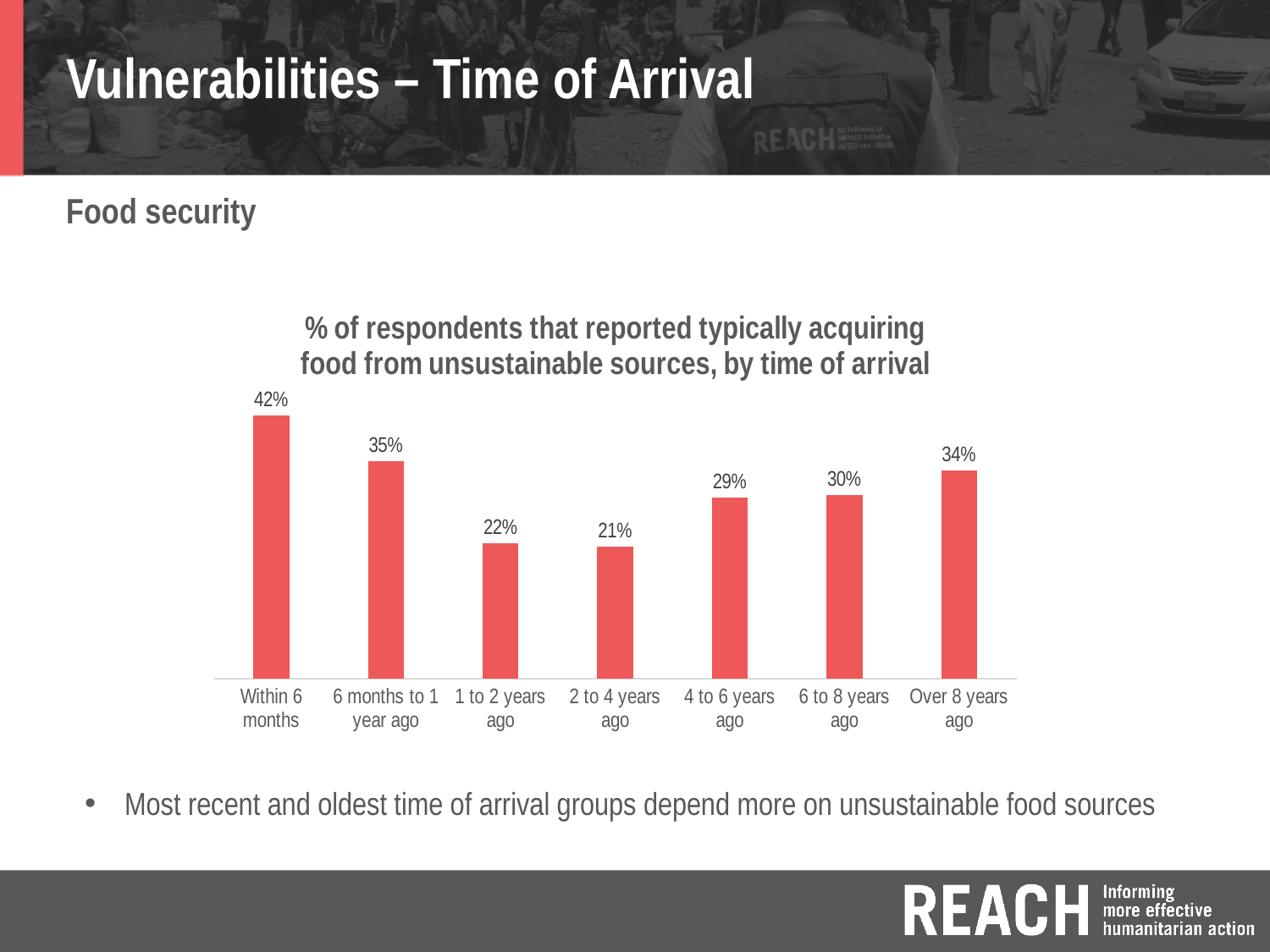
How many time of arrival groups are shown in the chart? 7 What is the value for the 'Over 8 years ago' group? 34% What is the difference between the '6 to 8 years ago' and '4 to 6 years ago' groups? 1 percentage point What percentage of respondents who arrived within 6 months reported typically acquiring food from unsustainable sources? 42% What is the difference in percentage points between the 'Within 6 months' group and the '2 to 4 years ago' group? 21 percentage points Which group has a higher value: '6 months to 1 year ago' or 'Over 8 years ago'? 6 months to 1 year ago Do the values rise or fall from '2 to 4 years ago' to 'Over 8 years ago'? Rise Which time of arrival group has the lowest percentage? 2 to 4 years ago What is the title of the chart? % of respondents that reported typically acquiring food from unsustainable sources, by time of arrival Which time of arrival group has the highest percentage of respondents acquiring food from unsustainable sources? Within 6 months What is the value for the '2 to 4 years ago' group? 21% What type of chart is used on this slide? Bar chart